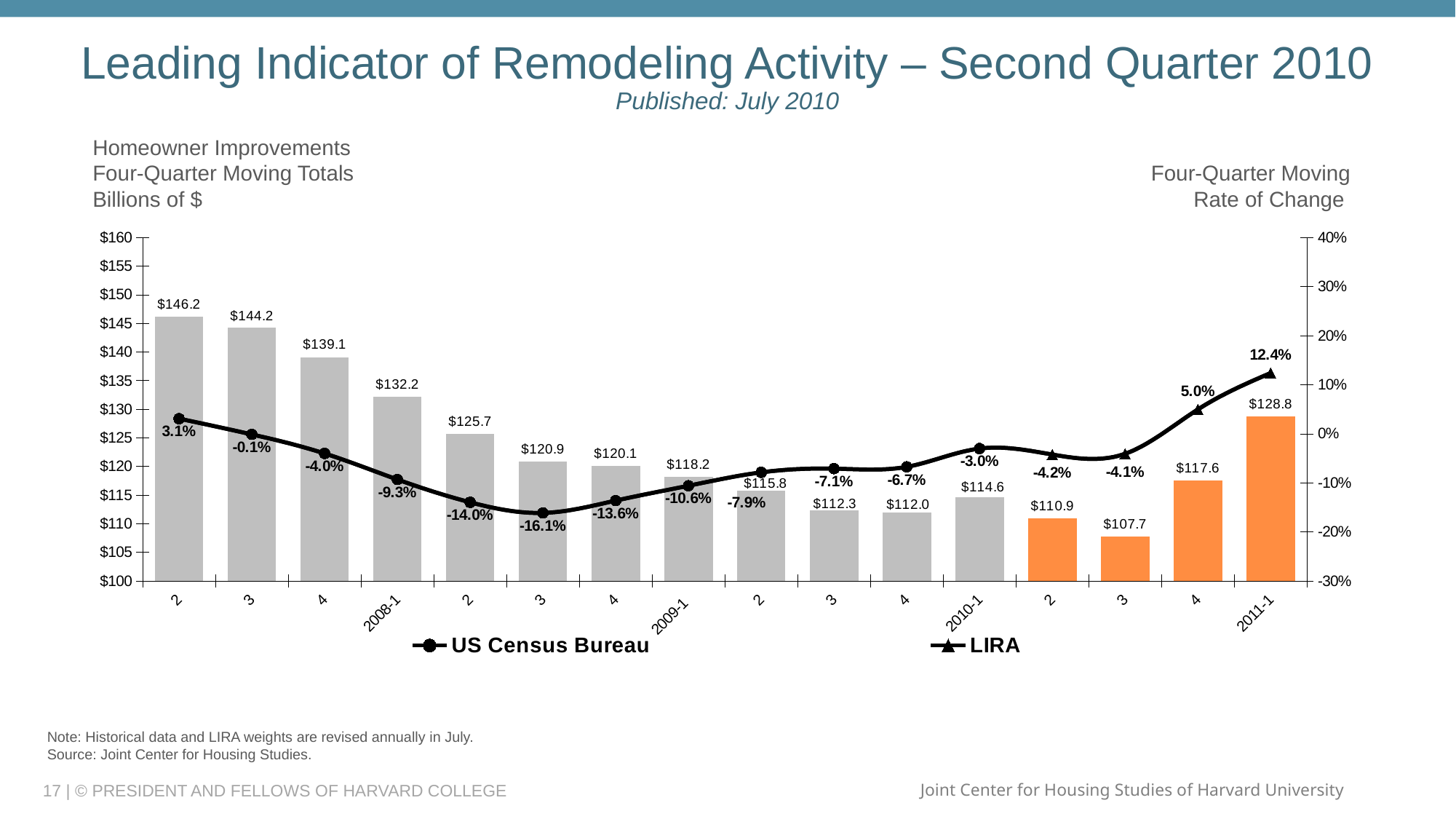
What is the highest four-quarter moving total shown by any bar? $146.2 Which has the larger four-quarter moving total, 2009-1 or 2010-1? 2009-1 What is the four-quarter moving total for 2011-1? $128.8 What is the lowest four-quarter moving total shown by any bar? $107.7 How many series does the legend list? 2 What is the four-quarter moving total for 2008-1? $132.2 How many bars are plotted on the chart? 16 By how much does the four-quarter moving total for 2011-1 exceed that for 2010-1? $14.2 What is the lowest four-quarter moving rate of change shown on the line? -16.1% What is the four-quarter moving rate of change at 2010-1? -3.0% What kind of chart is shown on the slide? A bar chart combined with a line chart What is the four-quarter moving rate of change at 2011-1? 12.4%